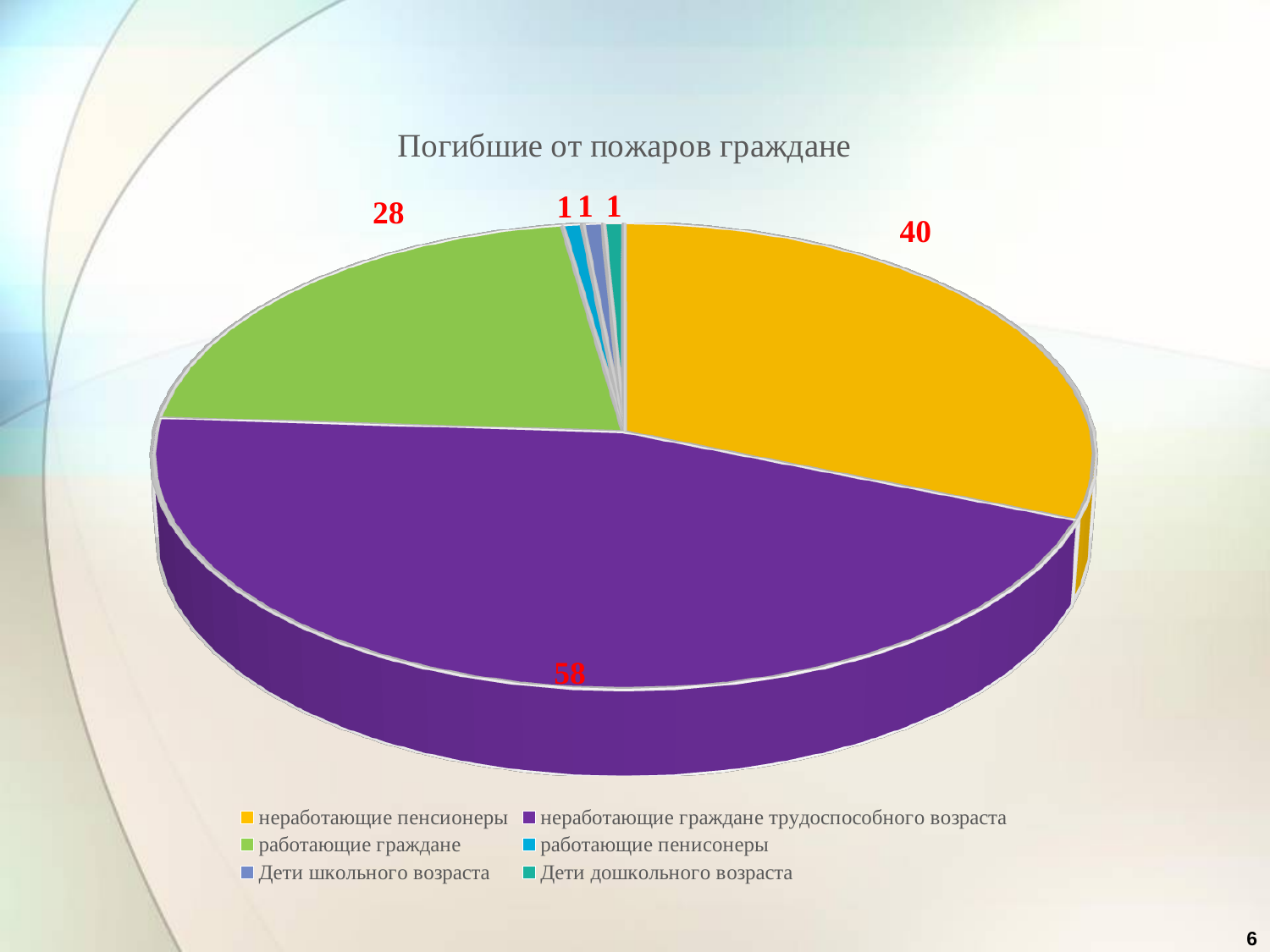
Which is larger, the value for неработающие пенсионеры or the value for работающие граждане? неработающие пенсионеры What is the value for неработающие пенсионеры? 40 How many categories does the legend list? 6 What type of chart is shown on the slide? Pie chart What is the total of all slices in the pie? 129 What is the value for работающие граждане? 28 What is the difference between the values for неработающие граждане трудоспособного возраста and неработающие пенсионеры? 18 What is the value for Дети школьного возраста? 1 Which category has the largest slice? неработающие граждане трудоспособного возраста What is the value for неработающие граждане трудоспособного возраста? 58 Which colour represents работающие граждане in the chart? Green What is the title of the chart? Погибшие от пожаров граждане